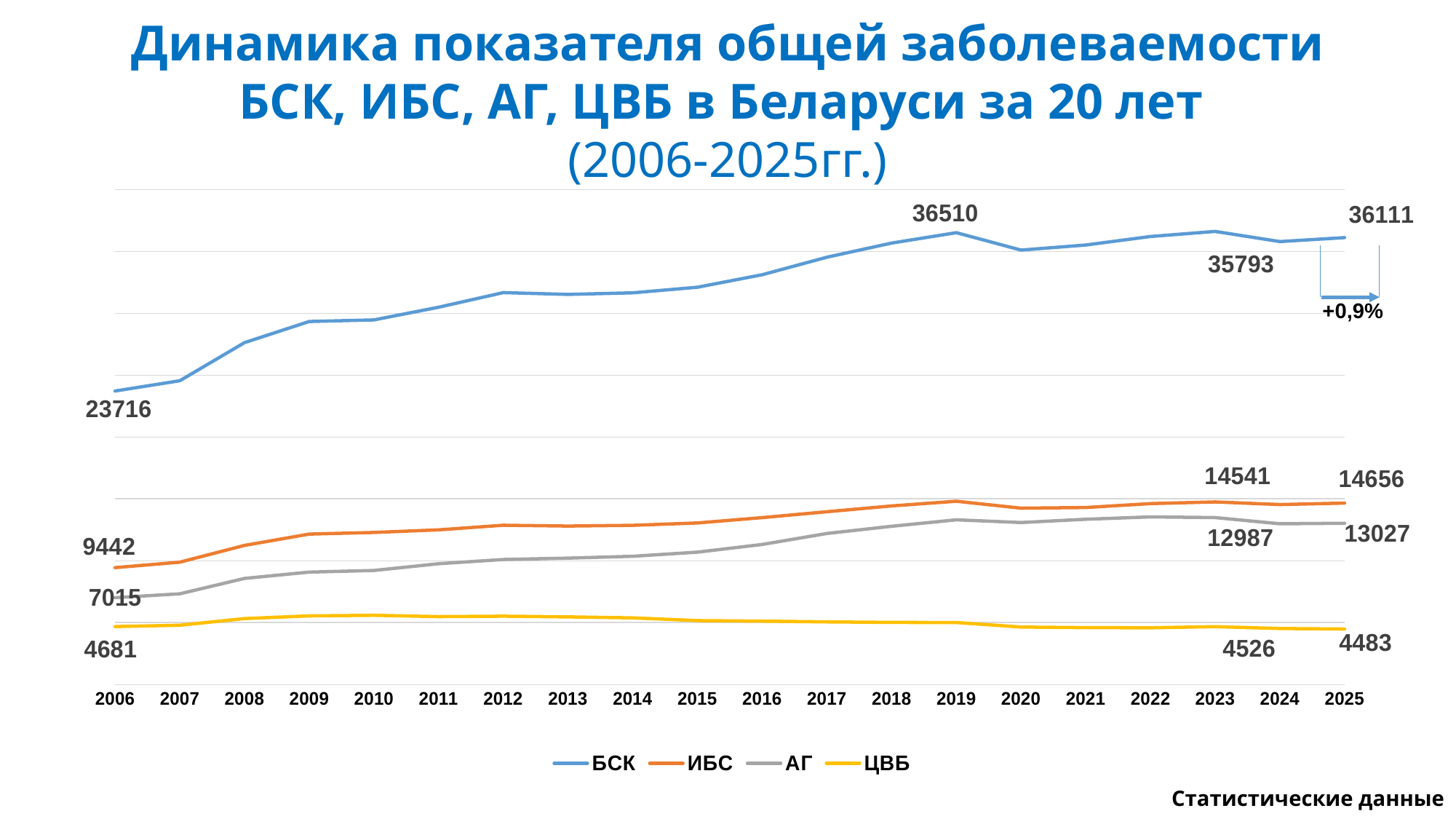
What type of chart is shown on the slide? line chart What is the value of БСК in 2025? 36111 What is the value of ИБС in 2025? 14656 Which series has the lowest value in 2025? ЦВБ Does the БСК line generally rise or fall from 2006 to 2025? rise How many series does the legend list? 4 Which series has the highest value in 2025? БСК By how much did the БСК value increase from 2006 to 2025? 12395 How many years are plotted along the x axis? 20 Which is larger in 2025, the value for ИБС or the value for АГ? ИБС What is the value of ЦВБ in 2006? 4681 What is the value of БСК in 2006? 23716